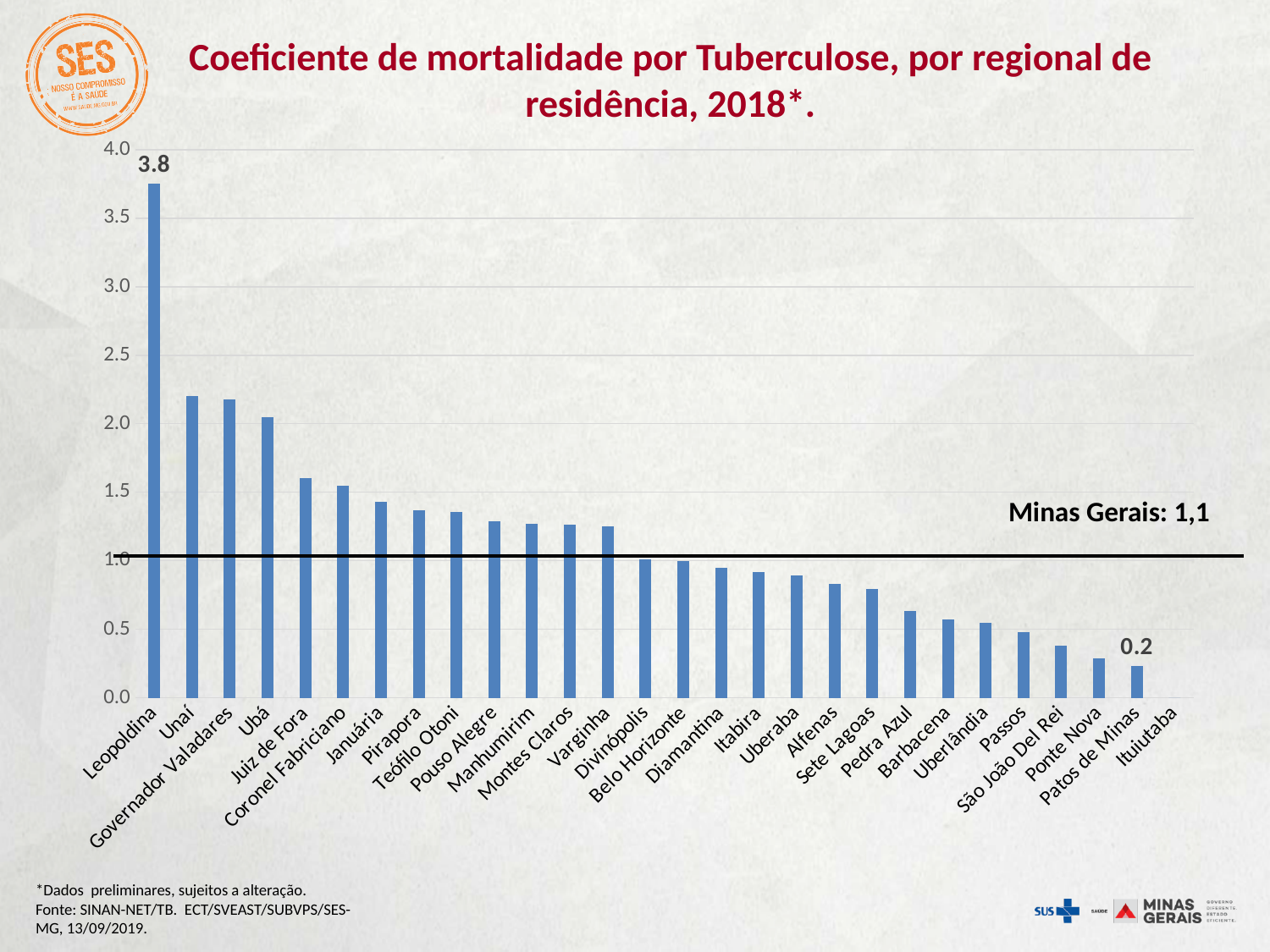
What value does the horizontal reference line labelled Minas Gerais represent? 1,1 What is the value for Ituiutaba? 0.2 Is the value for Ponte Nova greater or less than 0.5? less Do the values rise or fall from left to right along the x axis? Fall Is the value for Unaí greater or less than 2.0? greater What is the value for Leopoldina? 3.8 Which regional has the highest mortality coefficient? Leopoldina Which regional has the lowest mortality coefficient? Ituiutaba What kind of chart is shown on the slide? Bar chart Is the value for Januária greater or less than 1.5? less Which is larger, the value for Leopoldina or the value for Unaí? Leopoldina What is the difference between the values for Leopoldina and Ituiutaba? 3.6